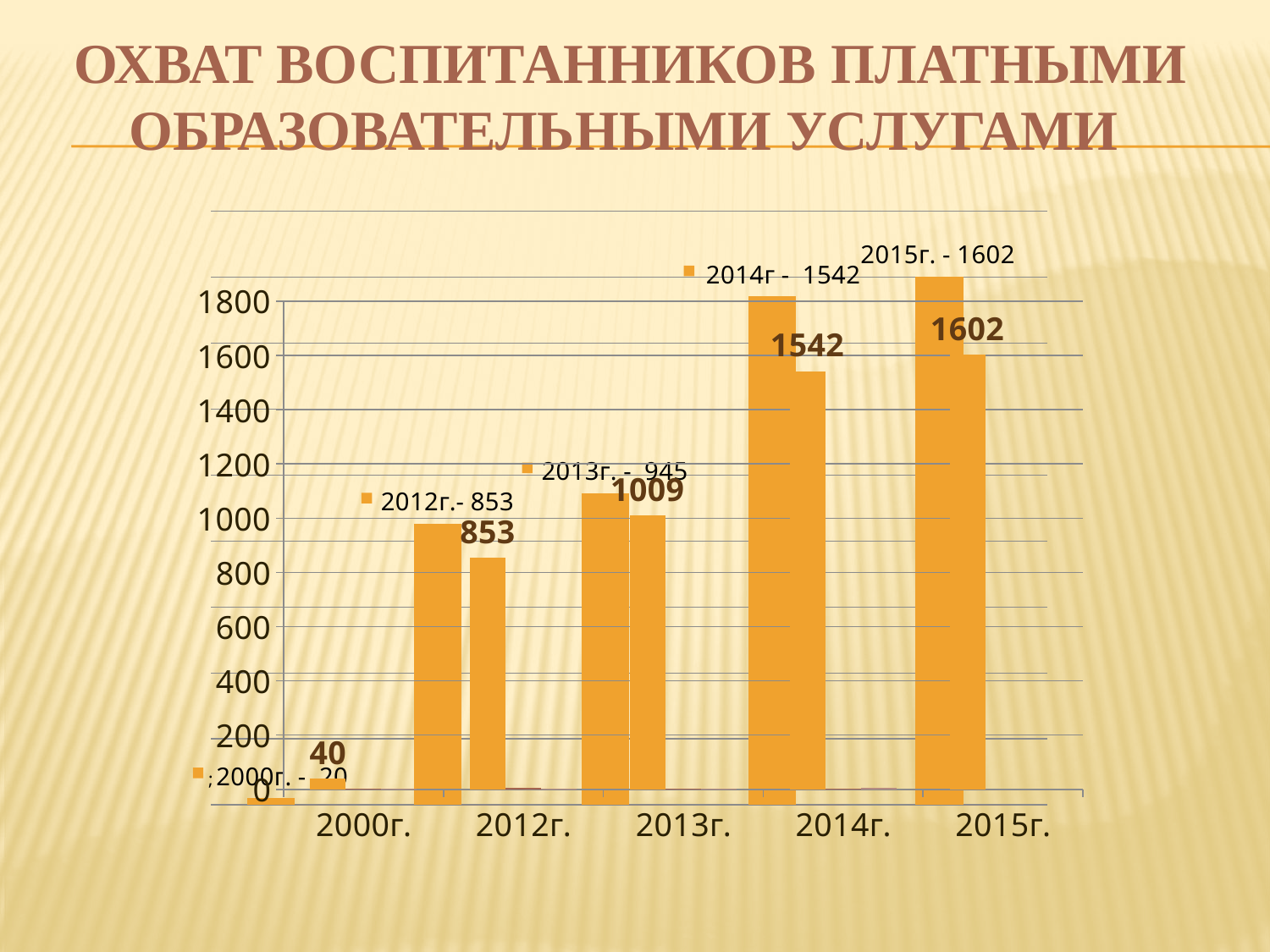
Which year has the lowest bold data label? 2000г. What is the bold data label shown for 2013г.? 1009 What is the bold data label shown for 2015г.? 1602 Which year has the highest bold data label? 2015г. Which is larger, the bold data label for 2014г. or for 2013г.? 2014г. What is the bold data label shown for 2000г.? 40 What kind of chart is shown on the slide? bar chart What is the bold data label shown for 2014г.? 1542 What is the bold data label shown for 2012г.? 853 How many year categories are shown on the x axis? 5 Do the values rise or fall from 2000г. to 2015г.? rise What is the difference between the bold data labels for 2015г. and 2014г.? 60